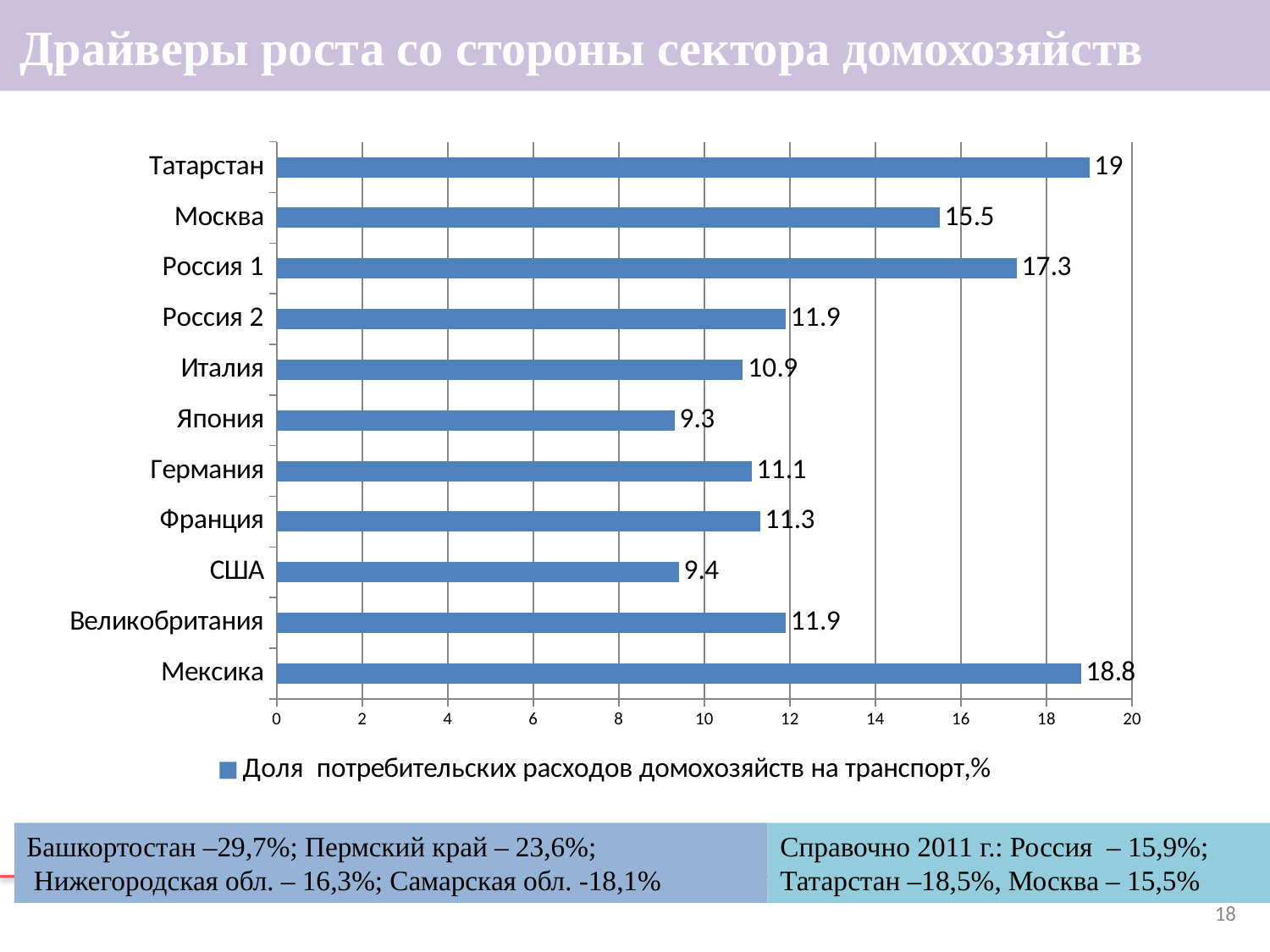
What is the value for Япония? 9.3 What is the value for Татарстан? 19 What kind of chart is shown on the slide? bar chart What is the value for Москва? 15.5 Which category has the lowest value? Япония Which category has the highest value? Татарстан How many series does the legend list? 1 What is the value for Мексика? 18.8 Is the value for Италия greater or less than 12? less How many categories are shown in the chart? 11 What is the difference between the values for Татарстан and Москва? 3.5 Which is larger, the value for Россия 1 or the value for Москва? Россия 1